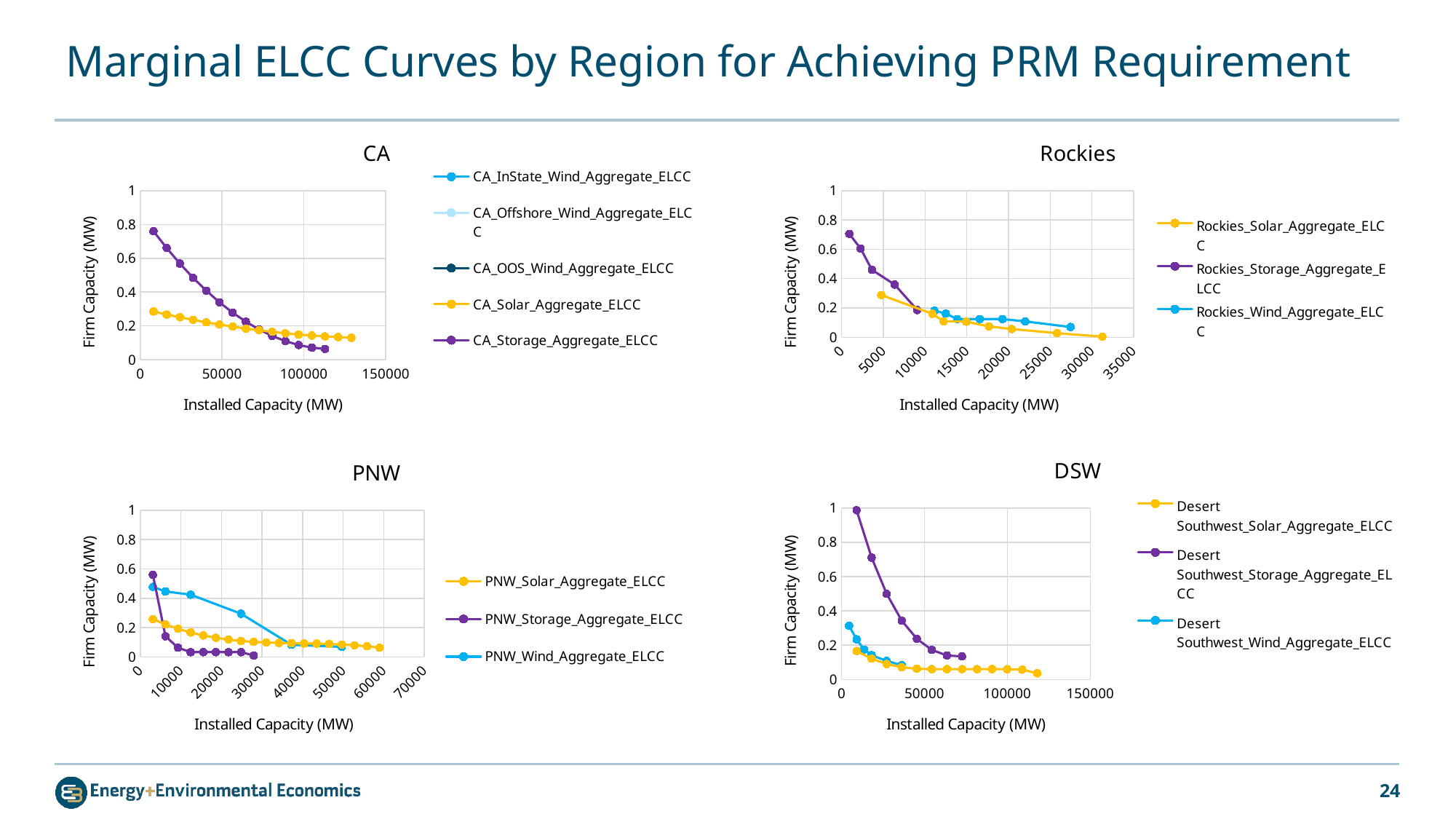
In the CA chart, does the CA_Storage_Aggregate_ELCC series rise or fall as installed capacity increases? fall In the DSW chart, does the Desert Southwest_Storage_Aggregate_ELCC series rise or fall along the x axis? fall How many series does the legend of the CA chart list? 5 How many series does the legend of the Rockies chart list? 3 In the PNW chart, at around 20000 MW installed capacity, which series is higher: PNW_Wind_Aggregate_ELCC or PNW_Storage_Aggregate_ELCC? PNW_Wind_Aggregate_ELCC In the DSW chart, is the first (leftmost) value of Desert Southwest_Storage_Aggregate_ELCC greater or less than 0.8? greater In the CA chart, is the first (leftmost) value of CA_Storage_Aggregate_ELCC greater or less than 0.6? greater What is the y-axis label on the PNW chart? Firm Capacity (MW) What kind of chart is the CA chart? line chart In the PNW chart, is the first (leftmost) value of PNW_Wind_Aggregate_ELCC greater or less than 0.4? greater How many series does the legend of the DSW chart list? 3 In the Rockies chart, which series reaches the highest firm capacity value? Rockies_Storage_Aggregate_ELCC